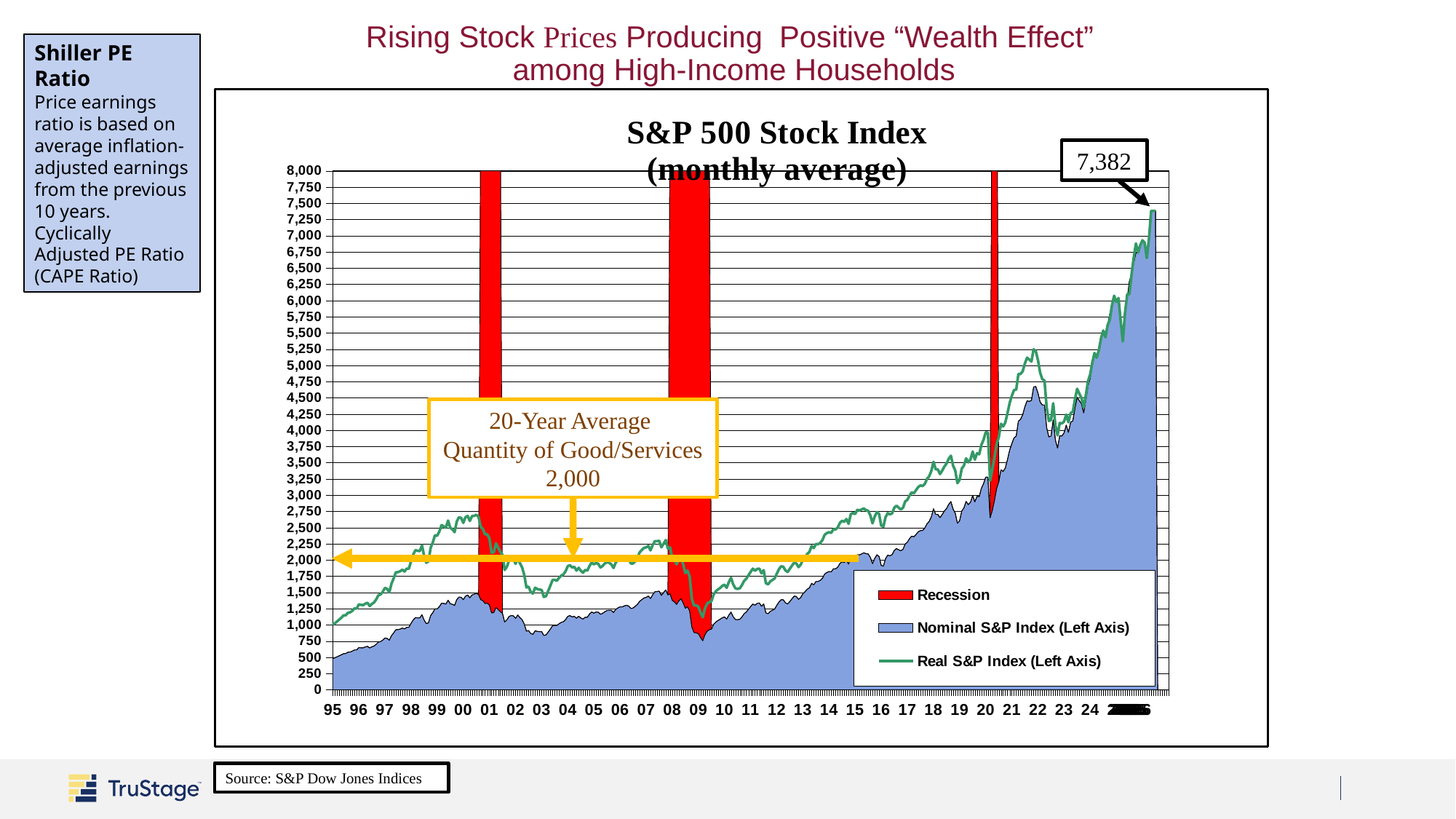
What colour is used for the Recession series in the chart? red Is the Nominal S&P Index value in 1995 greater or less than 1,000? less Is the peak of the Real S&P Index around 2000 greater or less than 2,500? greater What is the title of the chart on the slide? S&P 500 Stock Index (monthly average) Which is higher in 2010, the Real S&P Index or the Nominal S&P Index? Real S&P Index Is the Nominal S&P Index peak around 2022 greater or less than 4,000? greater What value is given for the 20-Year Average Quantity of Good/Services in the annotation box? 2,000 Does the Nominal S&P Index generally rise or fall from 1995 to the end of the chart? rise What value is printed in the callout at the right end of the S&P 500 chart? 7,382 How many recession bars are shaded on the chart? 3 How many series does the chart's legend list? 3